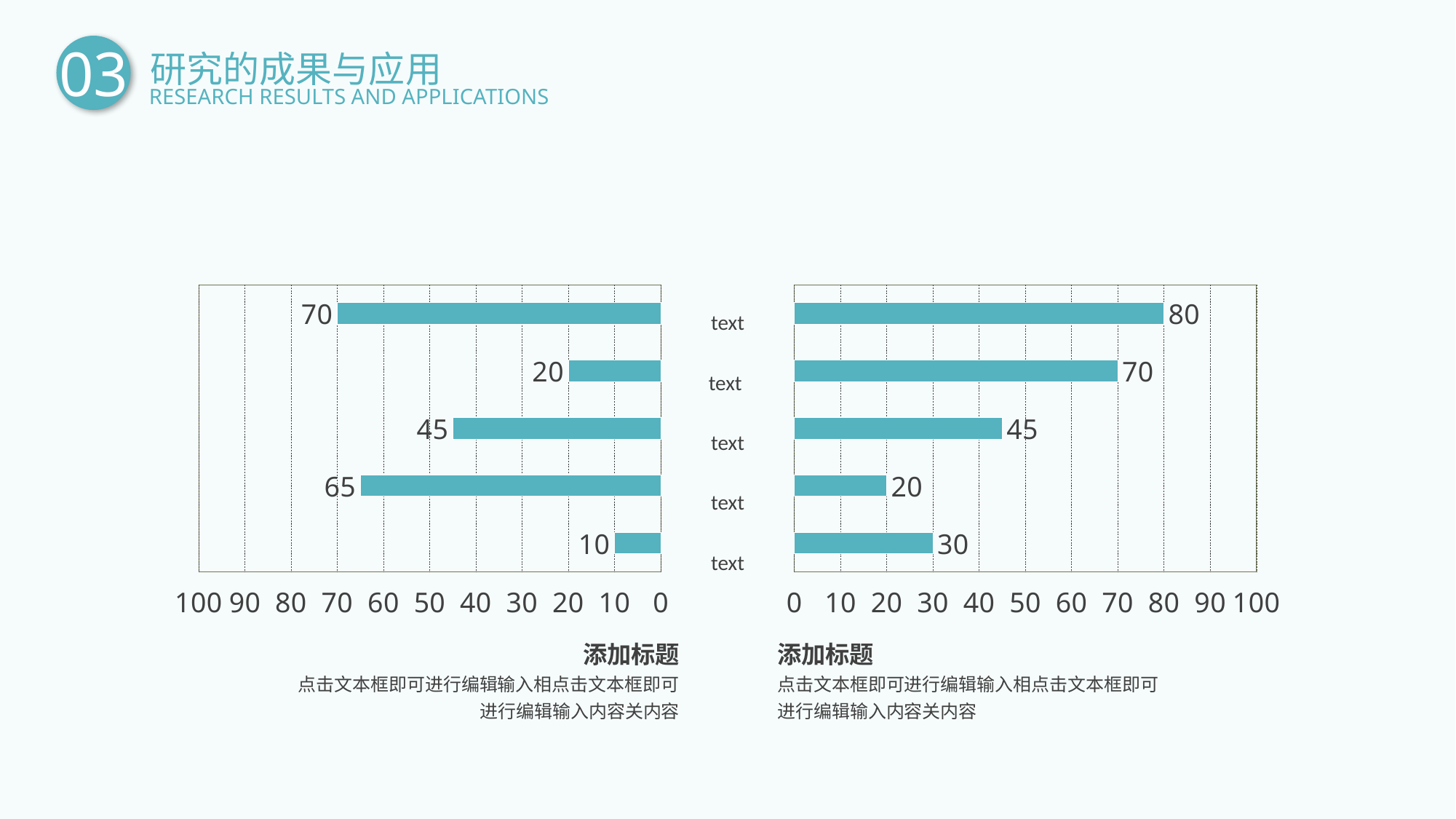
What type of chart is shown on the left side of the slide? bar chart In the left chart, what is the value of the top bar? 70 In the right chart, what is the value of the bottom bar? 30 In the left chart, what is the difference between the top bar (70) and the fourth bar (65)? 5 In the right chart, what is the difference between the top bar (80) and the bottom bar (30)? 50 In the right chart, what is the value of the top bar? 80 In the left chart, what is the lowest value shown? 10 In the right chart, what is the lowest value shown? 20 In the left chart, what is the highest value shown? 70 How many bars are plotted in the left chart? 5 In the left chart, what is the value of the bottom bar? 10 In the right chart, which is larger: the second bar from the top or the third bar from the top? the second bar (70)